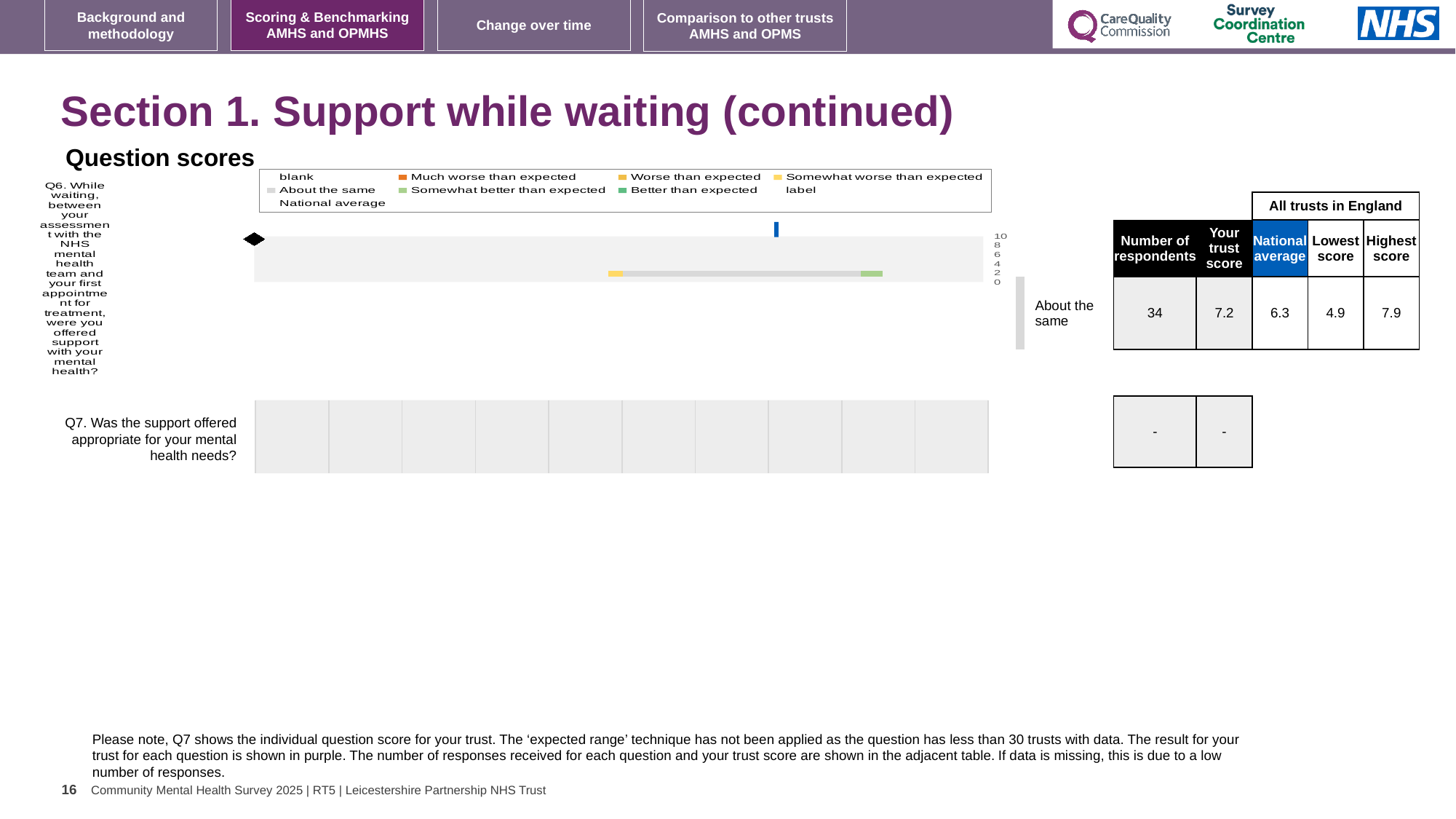
In the table beside the chart, what is the number of respondents for Q6? 34 In the table beside the chart, what is the national average for Q6? 6.3 In the chart legend, what colour represents "Much worse than expected"? orange In the table beside the chart, what is the highest score among all trusts in England for Q6? 7.9 What rating category is shown to the right of the Q6 bar? About the same For Q6, what is the difference between the highest score and the lowest score among all trusts in England? 3.0 What kind of chart is used to show the Q6 question score? bar chart For Q6, which is larger: the trust score or the national average? the trust score (7.2) In the table beside the chart, what is the lowest score among all trusts in England for Q6? 4.9 In the table beside the chart, what is the trust score for Q6? 7.2 In the chart legend, what colour represents "Better than expected"? green